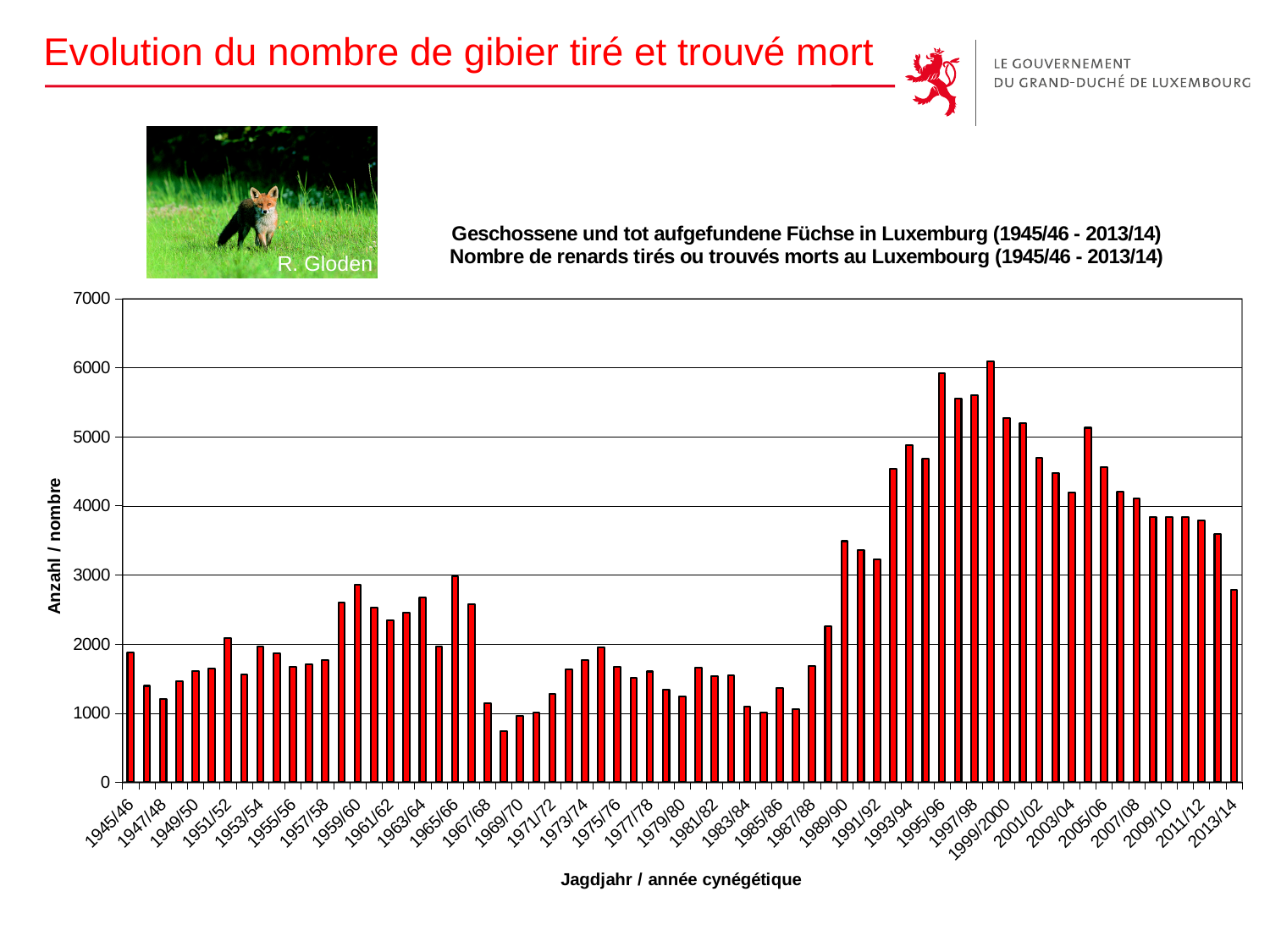
Is the value for 1995/96 greater or less than 5000? greater Do the values rise or fall from 2005/06 to 2013/14? fall Which hunting year has the lowest bar in the chart? 1968/69 What is the label of the vertical axis? Anzahl / nombre Which is larger, the value for 1995/96 or the value for 1945/46? 1995/96 Is the value for 2013/14 greater or less than 3000? less Is the value for 1945/46 greater or less than 1000? greater What kind of chart is shown on the slide? bar chart Which is larger, the value for 1969/70 or the value for 1989/90? 1989/90